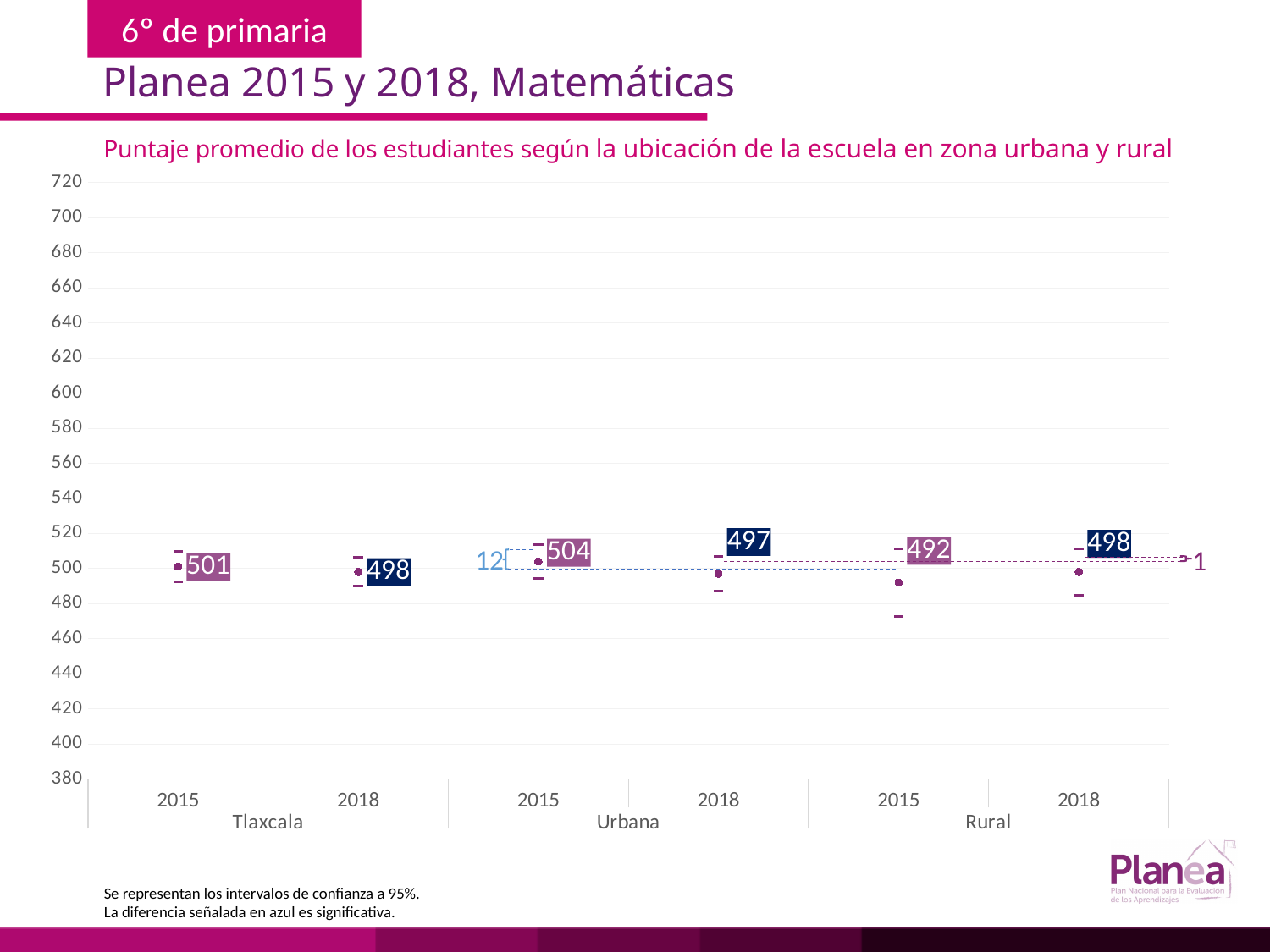
What is the difference between the Urbana 2015 score and the Urbana 2018 score? 7 How many data points are plotted on the chart? 6 Which group and year has the lowest average score? Rural 2015 What is the average score for Urbana schools in 2015? 504 What is the average score for Tlaxcala in 2015? 501 What is the average score for Rural schools in 2018? 498 What is the average score for Urbana schools in 2018? 497 What is the average score for Tlaxcala in 2018? 498 What is the title of the chart? Puntaje promedio de los estudiantes según la ubicación de la escuela en zona urbana y rural Which is larger, the Rural 2015 score or the Rural 2018 score? Rural 2018 Which group and year has the highest average score? Urbana 2015 What is the average score for Rural schools in 2015? 492